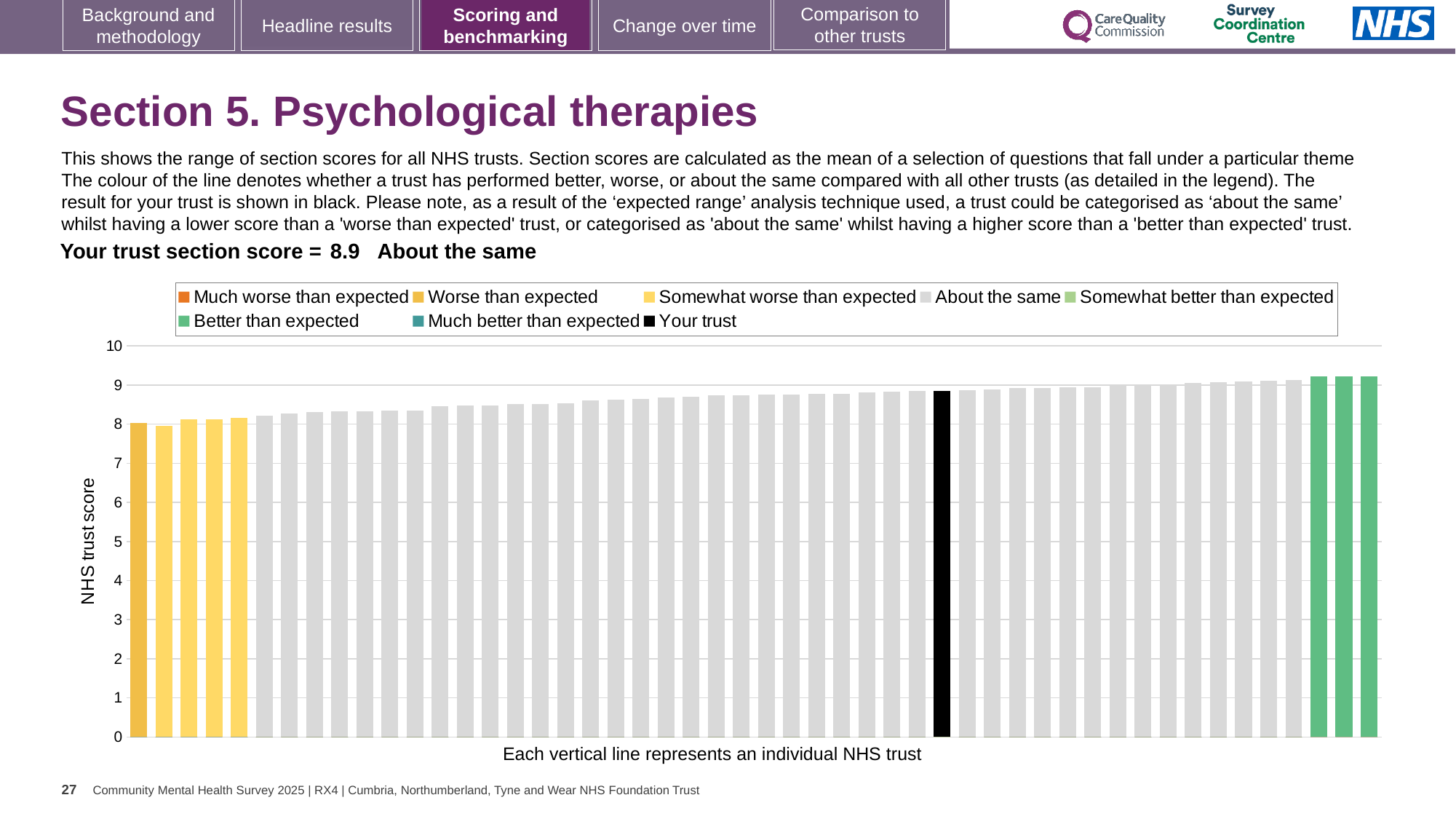
Is the value for your trust greater or less than 9? less How many entries does the chart legend list? 8 What is the title of the vertical axis? NHS trust score What colour is the bar representing your trust? black What is the section score for your trust shown on the slide? 8.9 Which category is your trust placed in for this section? About the same Which is larger, the leftmost bar or the rightmost bar? the rightmost bar Is the value for the rightmost bar greater or less than 9? greater What kind of chart is shown on the slide? bar chart How many bars are coloured green (Better than expected)? 3 Is the value for your trust greater or less than 8? greater Do the bar values rise or fall from left to right along the x axis? rise